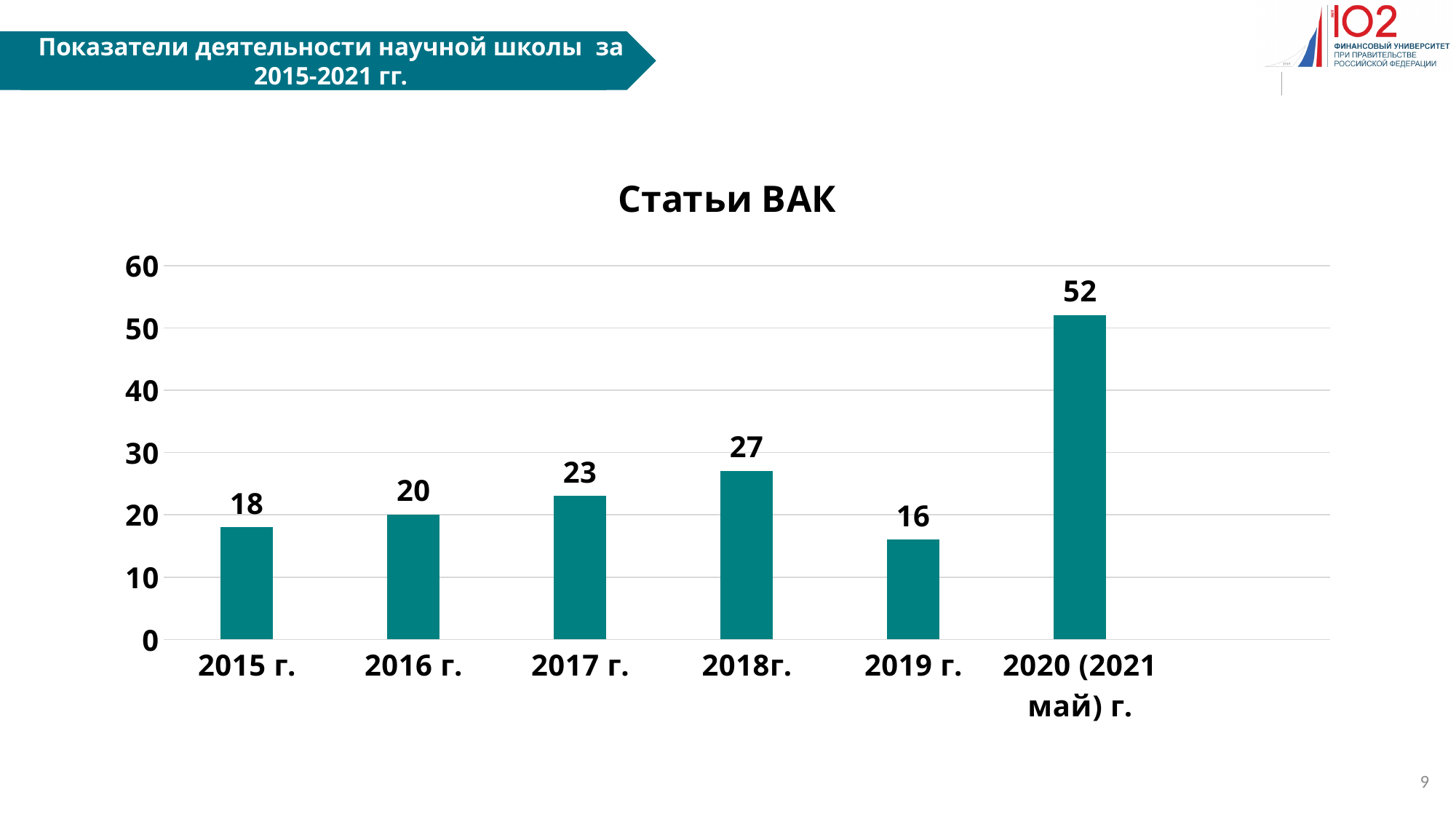
What kind of chart is shown on the slide? bar chart Which is larger, the value for 2016 г. or the value for 2019 г.? 2016 г. What is the value for 2020 (2021 май) г. in the Статьи ВАК chart? 52 Which category has the lowest value in the Статьи ВАК chart? 2019 г. How many categories are shown in the Статьи ВАК chart? 6 What is the difference between the values for 2018г. and 2017 г.? 4 What is the difference between the values for 2020 (2021 май) г. and 2019 г.? 36 Which category has the highest value in the Статьи ВАК chart? 2020 (2021 май) г. What is the title of the chart? Статьи ВАК What is the value for 2018г. in the Статьи ВАК chart? 27 Is the value for 2020 (2021 май) г. greater or less than 40? greater What is the value for 2015 г. in the Статьи ВАК chart? 18